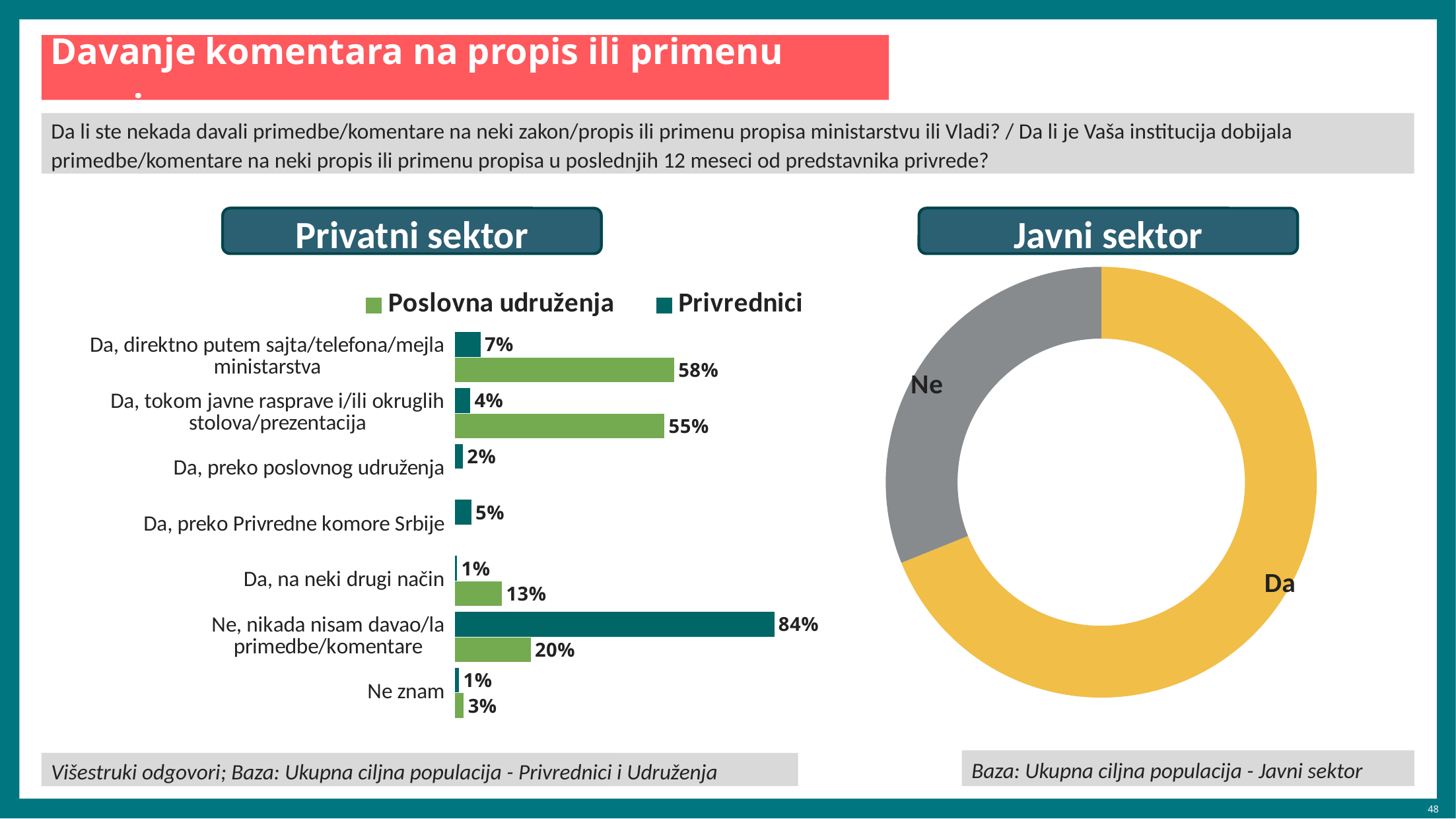
In the Privatni sektor chart, what is the value for Privrednici for 'Ne, nikada nisam davao/la primedbe/komentare'? 84% In the Privatni sektor chart, which category has the lowest value for Poslovna udruženja? Ne znam In the Privatni sektor chart, which series has the larger value for 'Da, na neki drugi način'? Poslovna udruženja In the Privatni sektor chart, what is the difference between Privrednici and Poslovna udruženja for 'Ne, nikada nisam davao/la primedbe/komentare'? 64% What kind of chart is the Javni sektor chart? Doughnut chart In the Privatni sektor chart, what is the value for Privrednici for 'Da, preko Privredne komore Srbije'? 5% In the Javni sektor chart, which slice is larger, Da or Ne? Da In the Privatni sektor chart, which category has the highest value for Privrednici? Ne, nikada nisam davao/la primedbe/komentare In the Privatni sektor chart, what is the value for Poslovna udruženja for 'Da, tokom javne rasprave i/ili okruglih stolova/prezentacija'? 55% In the Privatni sektor chart, what is the value for Poslovna udruženja for 'Da, direktno putem sajta/telefona/mejla ministarstva'? 58% How many series does the legend of the Privatni sektor chart list? 2 How many categories are shown in the Privatni sektor chart? 7